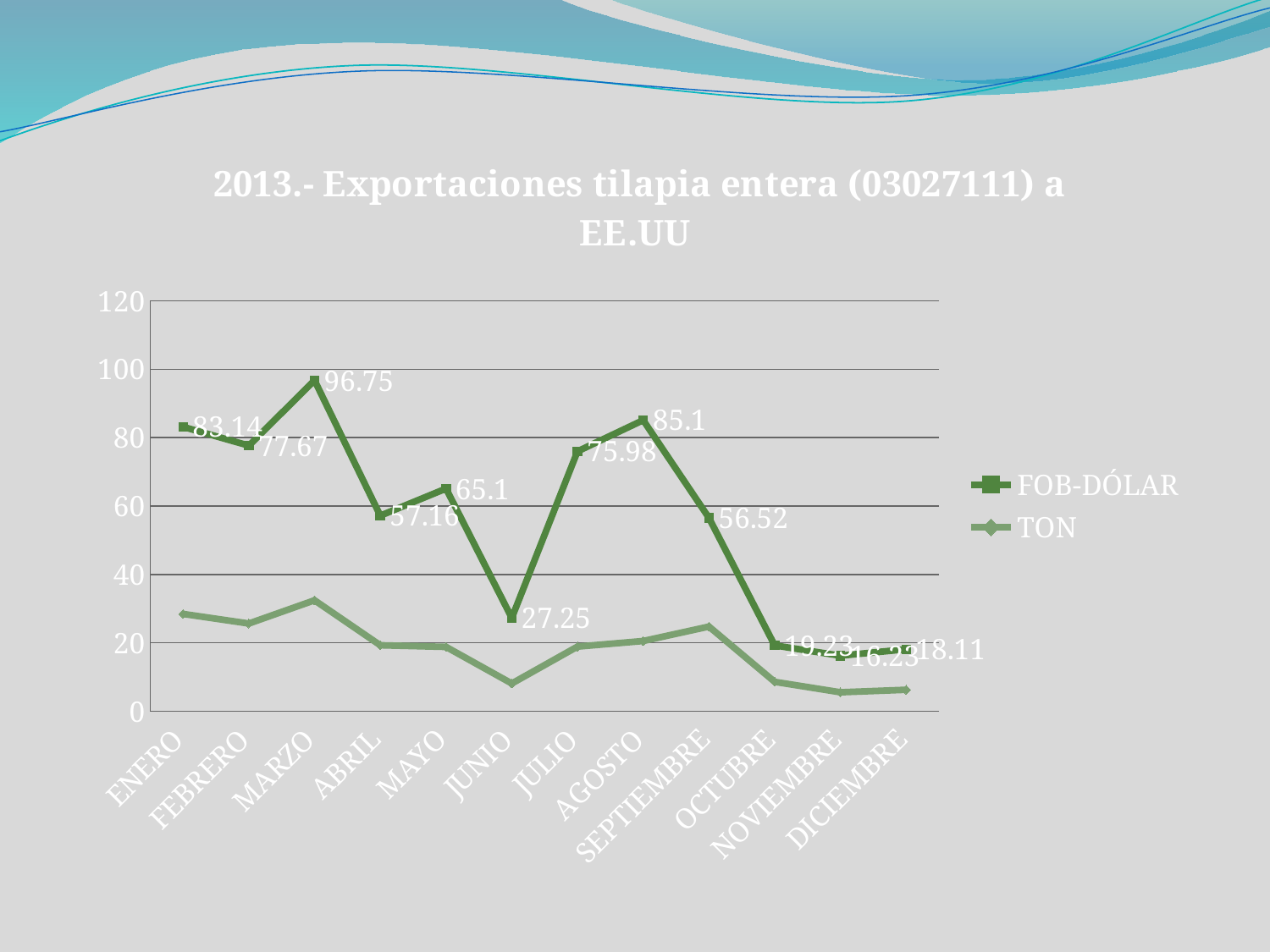
What is the FOB-DÓLAR value for MARZO? 96.75 Which is larger, the FOB-DÓLAR value for ENERO or for FEBRERO? ENERO Is the TON value for MARZO greater or less than 20? greater How many series does the legend list? 2 What kind of chart is shown on the slide? Line chart Which month has the highest FOB-DÓLAR value? MARZO Which month has the lowest FOB-DÓLAR value? NOVIEMBRE How many months are shown on the x axis? 12 What is the FOB-DÓLAR value for SEPTIEMBRE? 56.52 What is the difference between the FOB-DÓLAR values for AGOSTO and JULIO? 9.12 Is the TON value for JUNIO greater or less than 20? less What is the FOB-DÓLAR value for JUNIO? 27.25